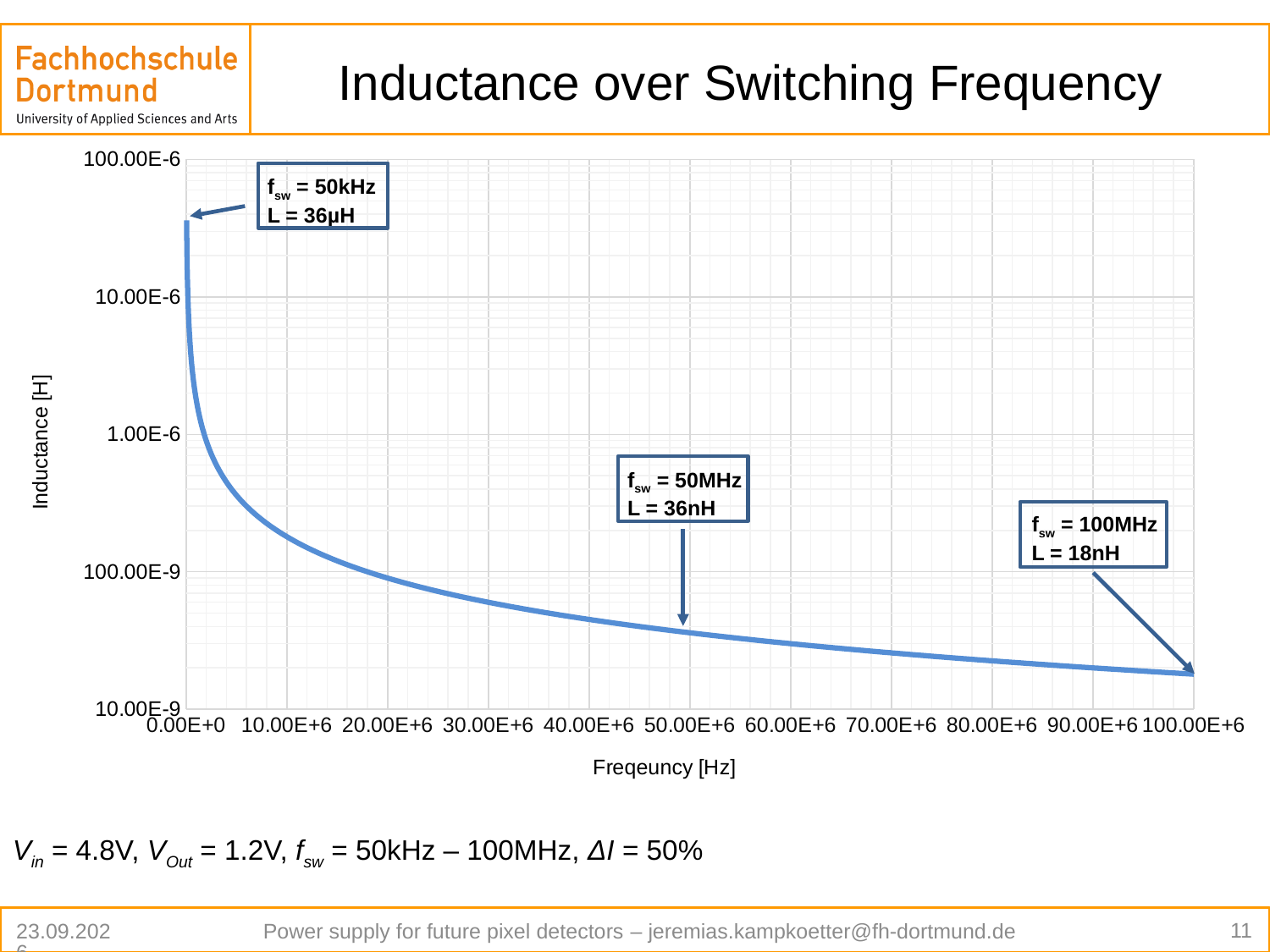
Which annotated switching frequency has the highest inductance? 50kHz Which annotated switching frequency has the lowest inductance? 100MHz What is the title of the chart? Inductance over Switching Frequency What is the inductance L at a switching frequency of 50kHz according to the annotation? 36µH Is the inductance at a frequency of 10.00E+6 Hz greater or less than 1.00E-6 H? less What is the inductance L at a switching frequency of 100MHz according to the annotation? 18nH Does the inductance rise or fall as the frequency increases along the x axis? fall What is the inductance L at a switching frequency of 50MHz according to the annotation? 36nH What is the difference in inductance between the 50MHz point and the 100MHz point? 18nH What kind of chart is shown on the slide? line chart Is the inductance larger at 50MHz or at 100MHz? 50MHz What is the label of the y axis? Inductance [H]